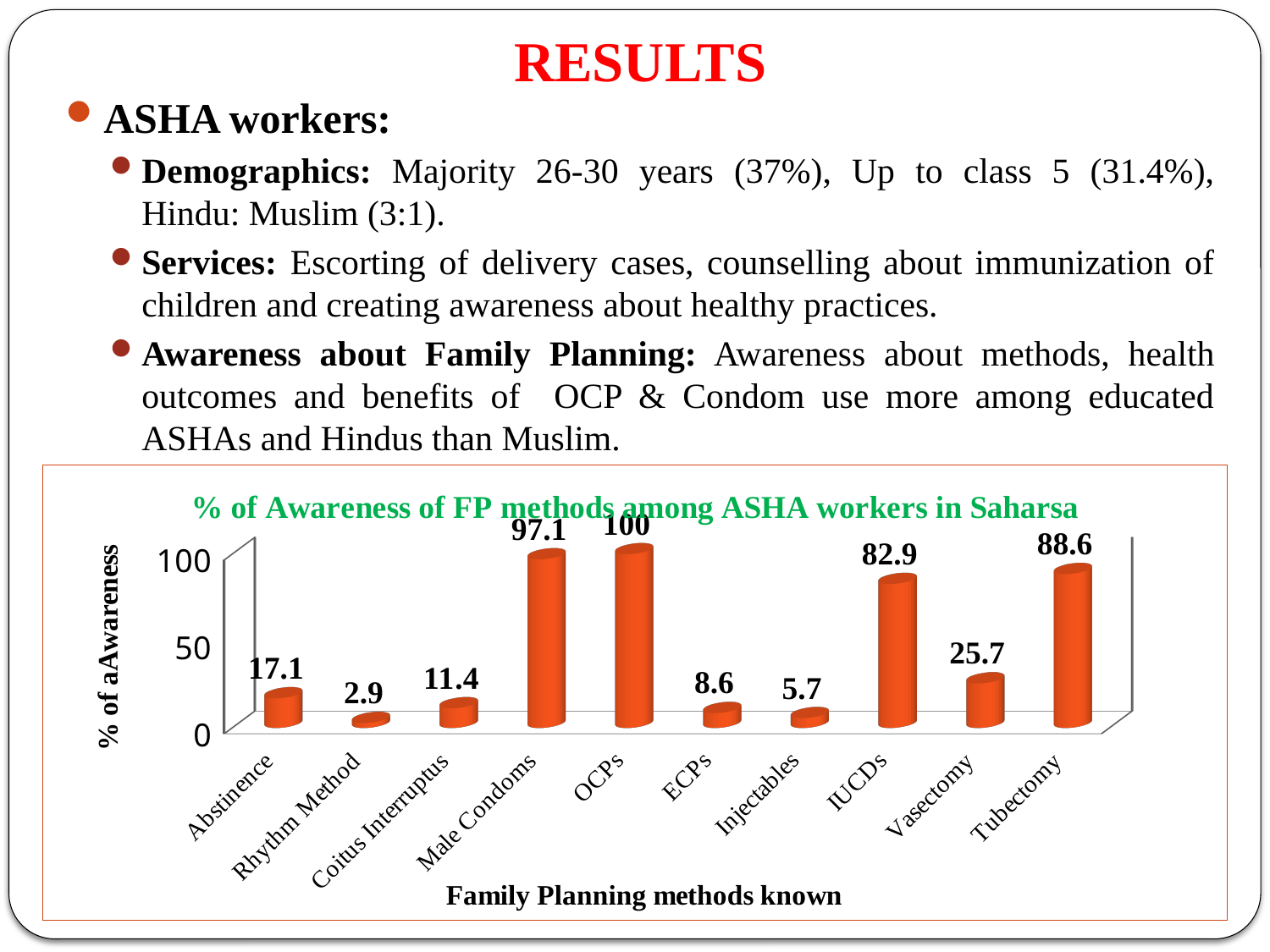
What is the title of the chart? % of Awareness of FP methods among ASHA workers in Saharsa Is the value for Vasectomy greater or less than 50? less Which has a larger value, ECPs or Injectables? ECPs How many family planning methods are shown on the x axis of the chart? 10 What is the value for IUCDs in the chart? 82.9 What is the value for Vasectomy in the chart? 25.7 What kind of chart is shown on the slide? bar chart Which family planning method has the highest awareness value in the chart? OCPs What is the value for Male Condoms in the chart? 97.1 What is the difference between the values for Abstinence and Coitus Interruptus? 5.7 Which family planning method has the lowest awareness value in the chart? Rhythm Method What is the difference between the values for Tubectomy and IUCDs? 5.7